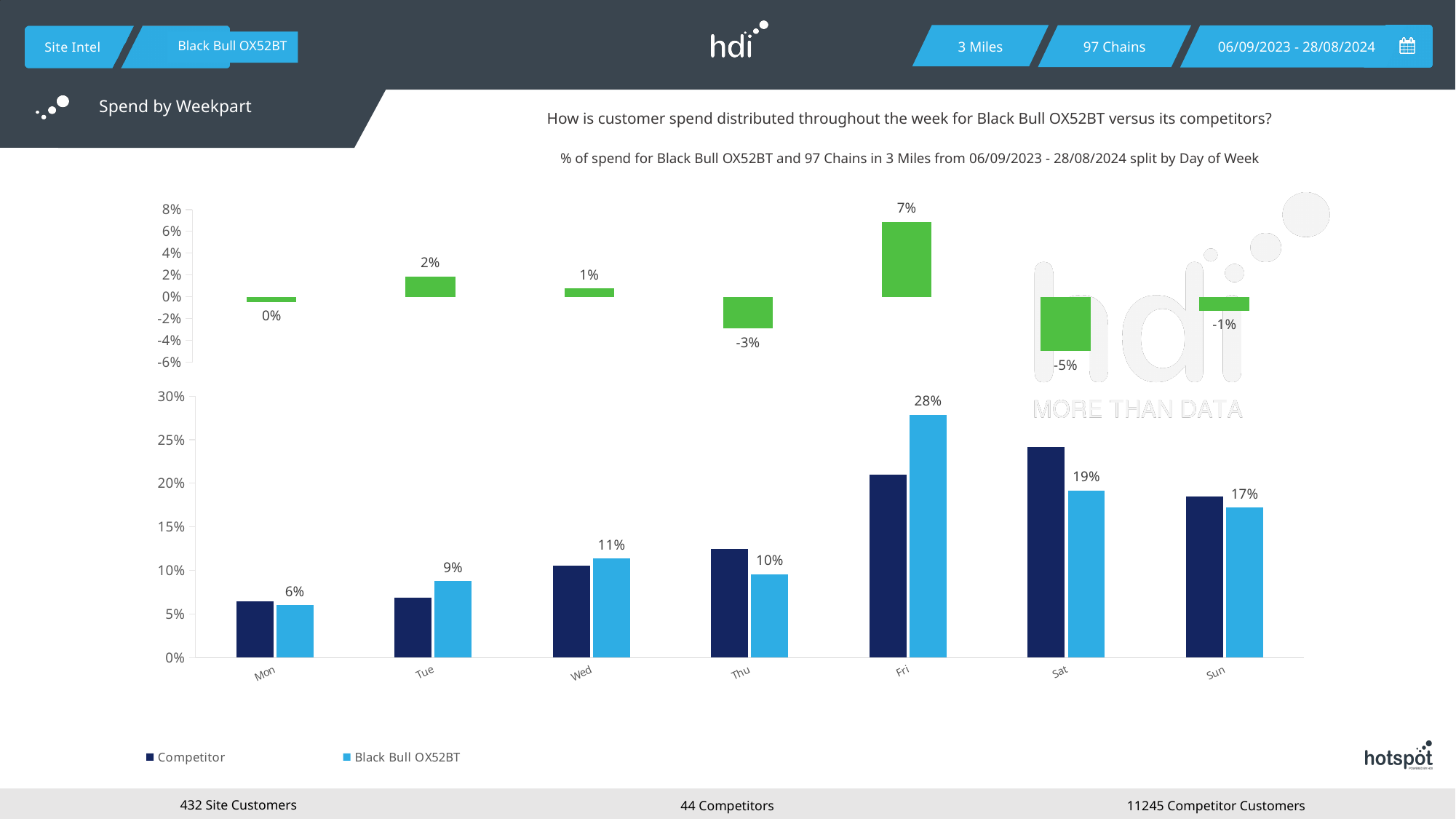
How many days are shown on the x axis of the bottom chart? 7 In the bottom chart, how many series does the legend list? 2 In the bottom chart, which day has the highest Black Bull OX52BT value? Fri In the bottom chart, what is the value for Black Bull OX52BT on Mon? 6% In the top chart, what is the value for Sat? -5% In the top chart, which day has the highest value? Fri In the bottom chart, what is the difference between the Black Bull OX52BT values for Fri and Sat? 9% In the bottom chart, what is the value for Black Bull OX52BT on Fri? 28% What kind of chart is the bottom chart? Bar chart In the bottom chart, which day has the lowest Black Bull OX52BT value? Mon In the bottom chart, is the Competitor value for Mon greater or less than 10%? less In the bottom chart, is the Competitor value for Sat greater or less than 20%? greater